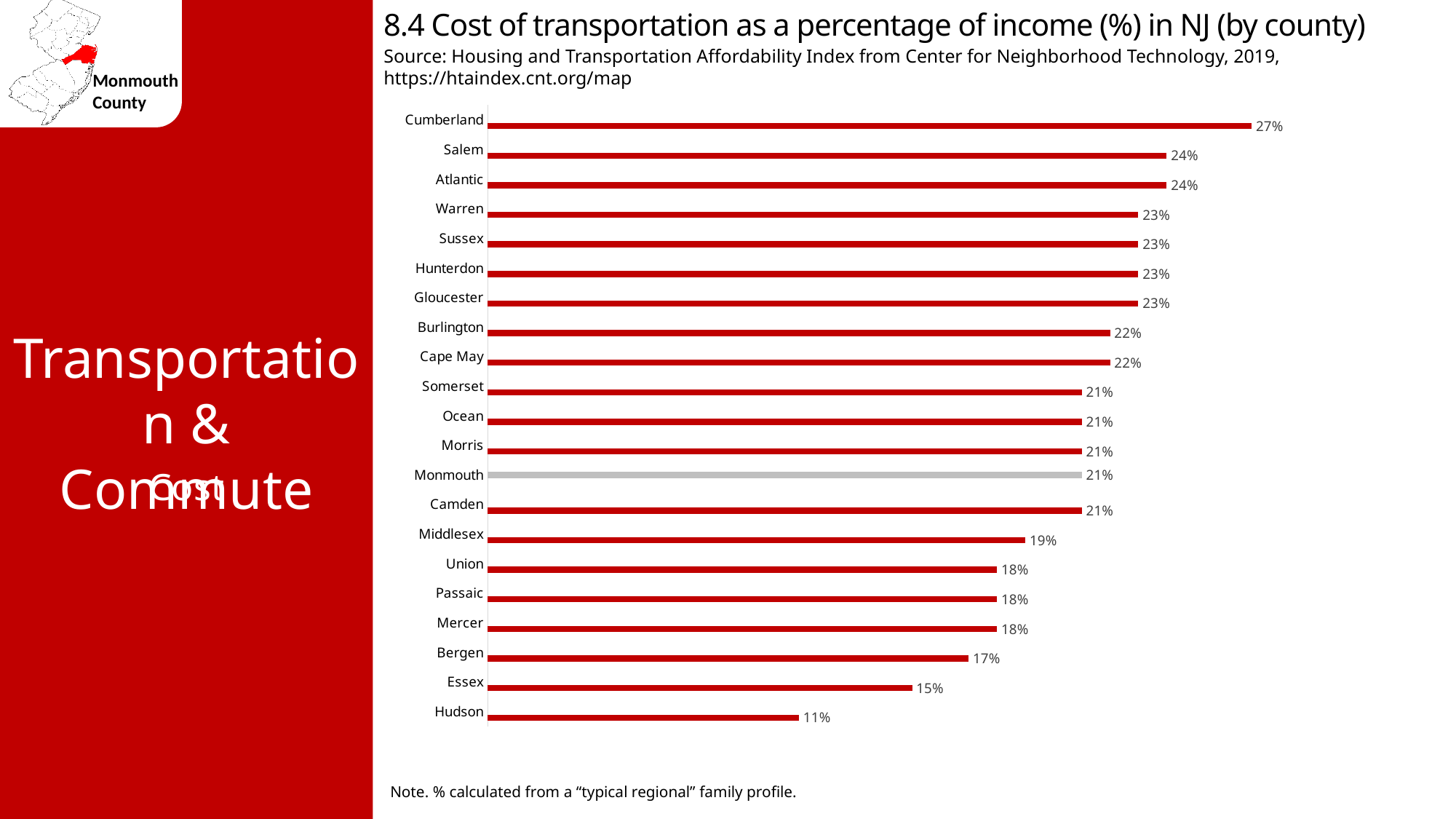
What is the value shown for Essex County? 15% What is the cost of transportation as a percentage of income for Monmouth County? 21% Which county has the highest cost of transportation as a percentage of income? Cumberland What kind of chart is shown on the slide? Bar chart Which county has a larger value, Bergen or Middlesex? Middlesex What is the cost of transportation as a percentage of income for Hudson County? 11% Which county's bar is shown in grey rather than red? Monmouth What is the value shown for Cumberland County? 27% Which county has the lowest cost of transportation as a percentage of income? Hudson What is the difference between the values for Cumberland and Hudson? 16% How many counties are shown in the chart? 21 What is the difference between the values for Monmouth and Essex? 6%